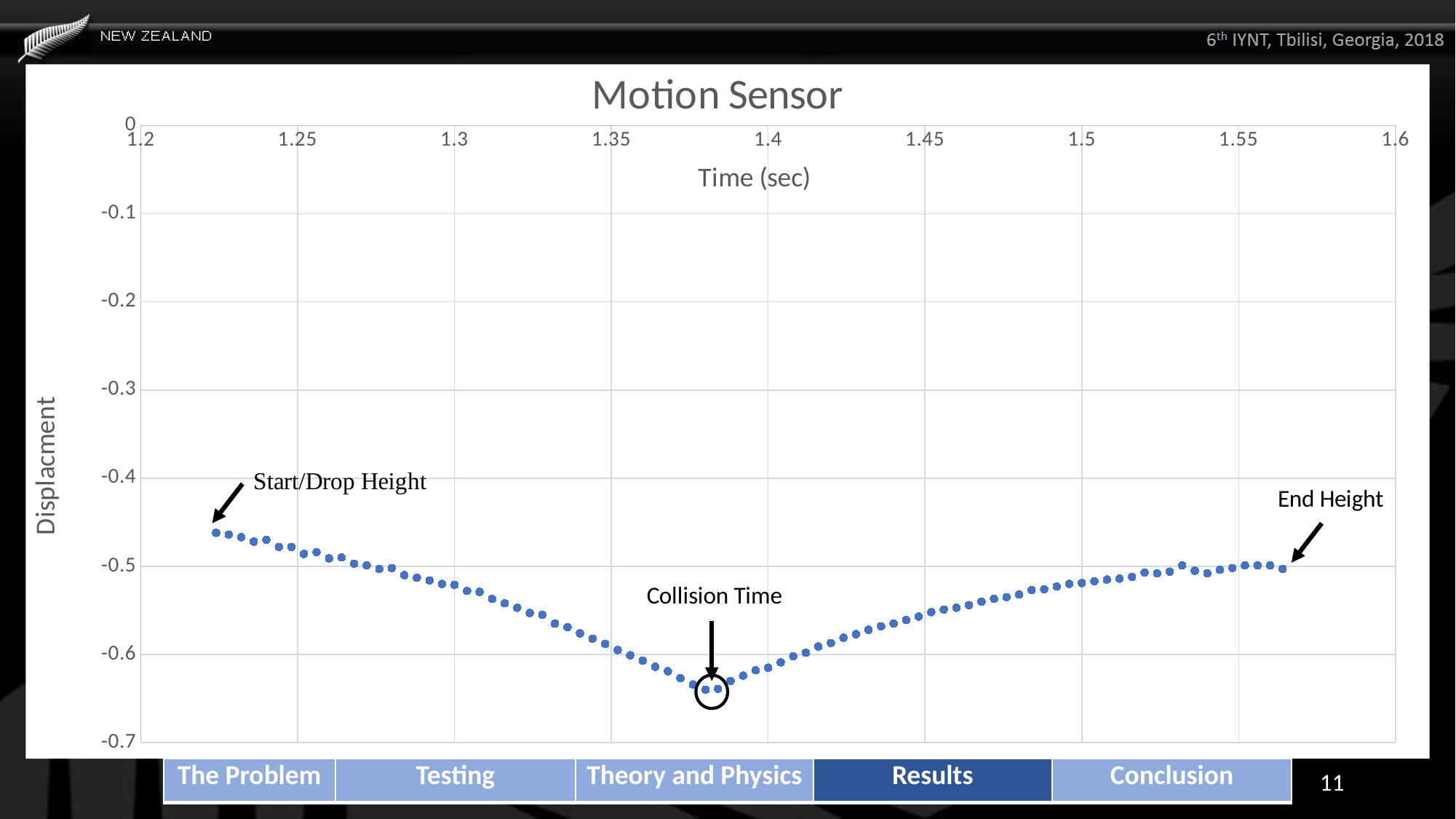
At which annotated point does the displacement reach its lowest value? Collision Time Does the displacement rise or fall along the x axis between the Collision Time and the End Height? rise What are the three annotated points on the chart labelled? Start/Drop Height, Collision Time, End Height Is the displacement at 1.3 sec greater or less than -0.5? less Is the displacement at the Collision Time greater or less than -0.6? less Is the displacement at the Start/Drop Height greater or less than -0.5? greater What is the title of the chart? Motion Sensor Which annotated point has the higher displacement, Start/Drop Height or End Height? Start/Drop Height What kind of chart is shown on the slide? scatter chart Does the displacement rise or fall along the x axis between the Start/Drop Height and the Collision Time? fall